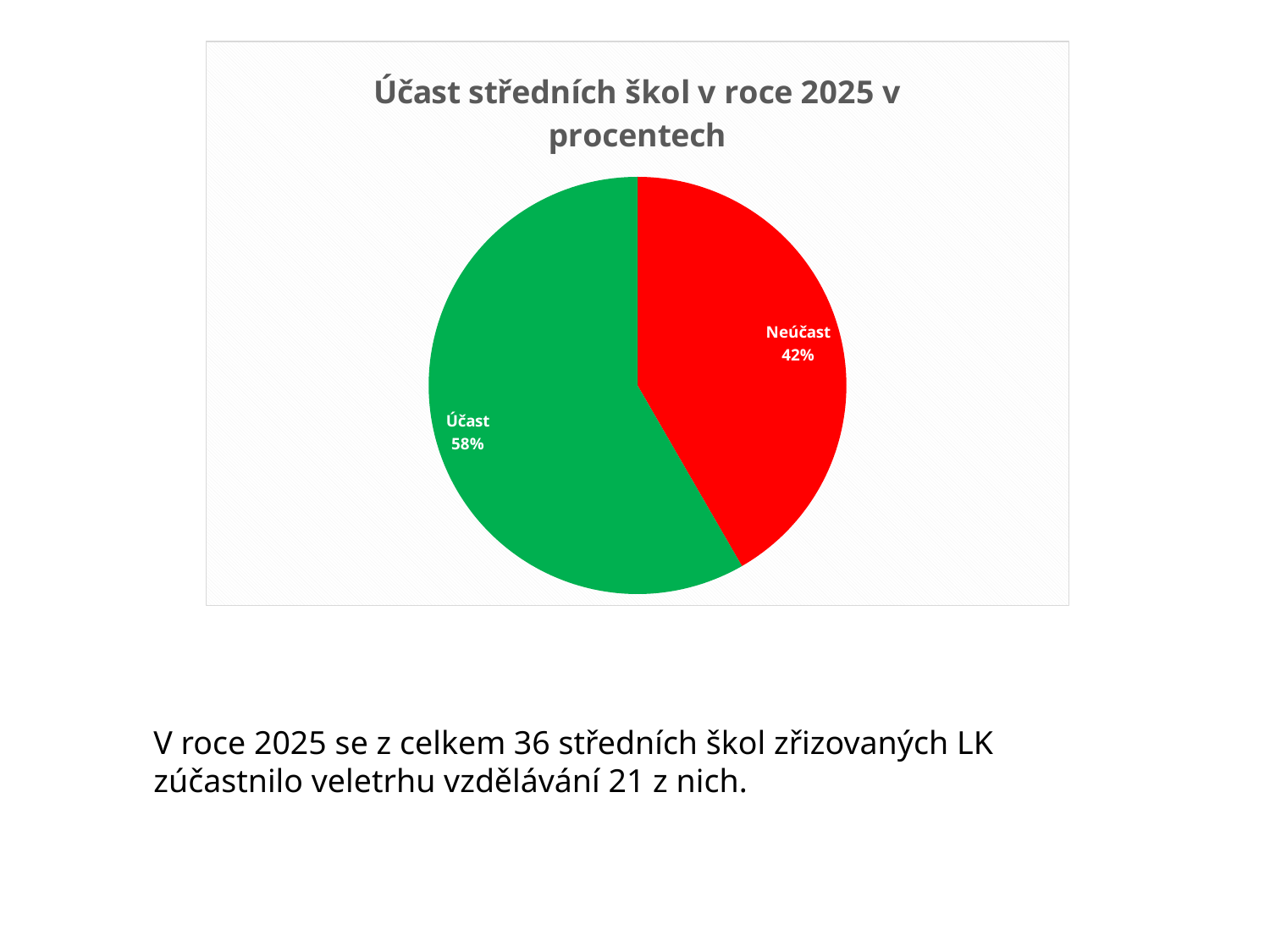
What is the difference in percentage points between the Účast and Neúčast slices? 16% What is the total of the two slices shown in the pie chart? 100% Is the value for Účast greater or less than 50%? greater What share of the pie does the Neúčast slice represent? 42% Which slice is the largest in the pie chart? Účast How many slices does the pie chart have? 2 What is the title of the chart? Účast středních škol v roce 2025 v procentech What kind of chart is shown on the slide? Pie chart What share of the pie does the Účast slice represent? 58% Which slice is the smallest in the pie chart? Neúčast What colour is the Neúčast slice? Red Which is larger, the Účast slice or the Neúčast slice? Účast